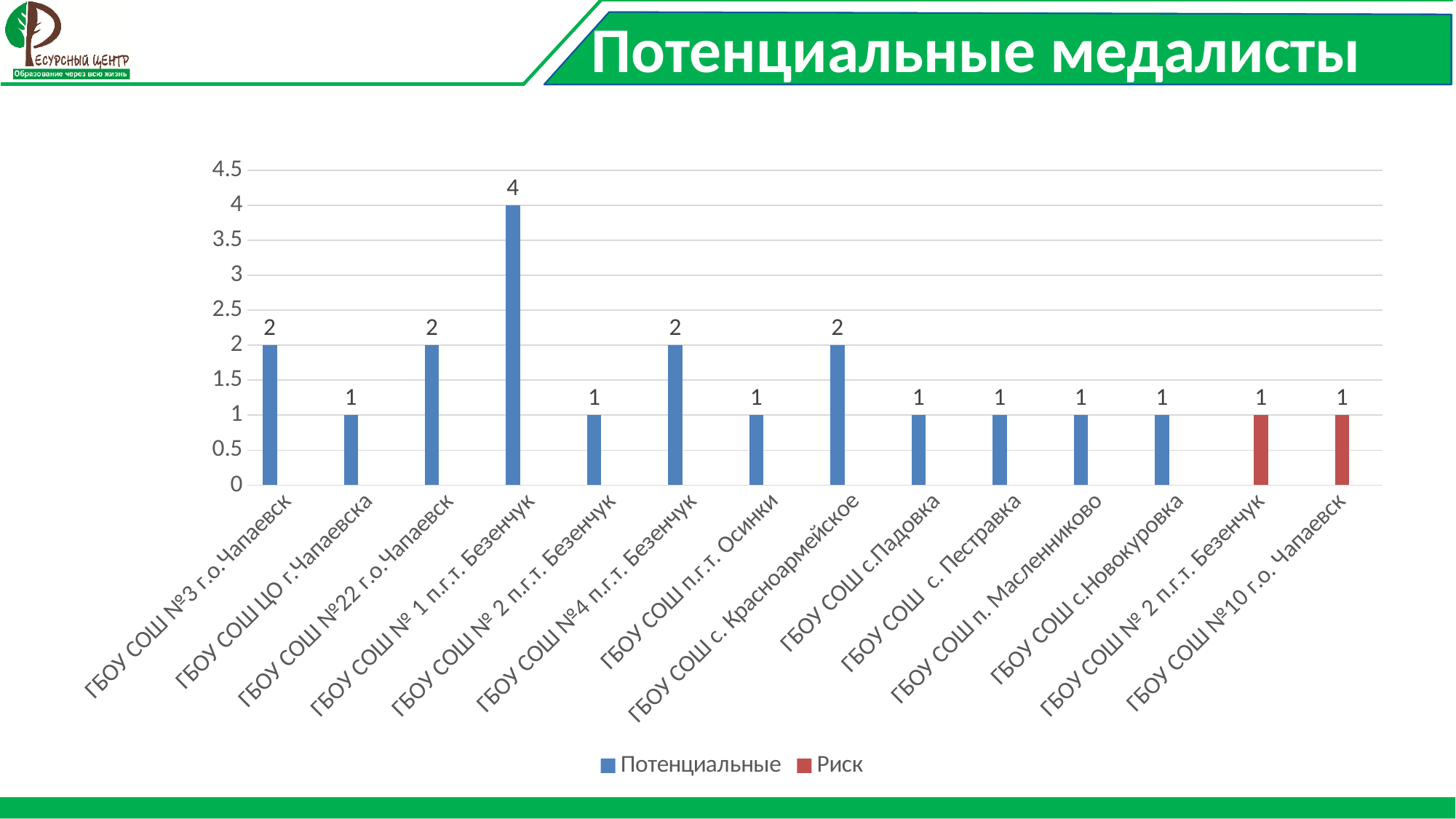
How many categories (schools) are shown on the x axis? 14 Which is larger, the value for ГБОУ СОШ №4 п.г.т. Безенчук or the value for ГБОУ СОШ с.Падовка? ГБОУ СОШ №4 п.г.т. Безенчук What is the difference between the values for ГБОУ СОШ № 1 п.г.т. Безенчук and ГБОУ СОШ №22 г.о.Чапаевск? 2 What is the value for ГБОУ СОШ с. Красноармейское? 2 How many series does the legend list? 2 Which series in the legend is shown in red? Риск What is the value for ГБОУ СОШ № 1 п.г.т. Безенчук? 4 What is the value for ГБОУ СОШ п.г.т. Осинки? 1 What is the value for ГБОУ СОШ №3 г.о.Чапаевск? 2 What type of chart is shown on the slide? bar chart What is the value for ГБОУ СОШ №10 г.о. Чапаевск? 1 Which school has the highest value in the chart? ГБОУ СОШ № 1 п.г.т. Безенчук